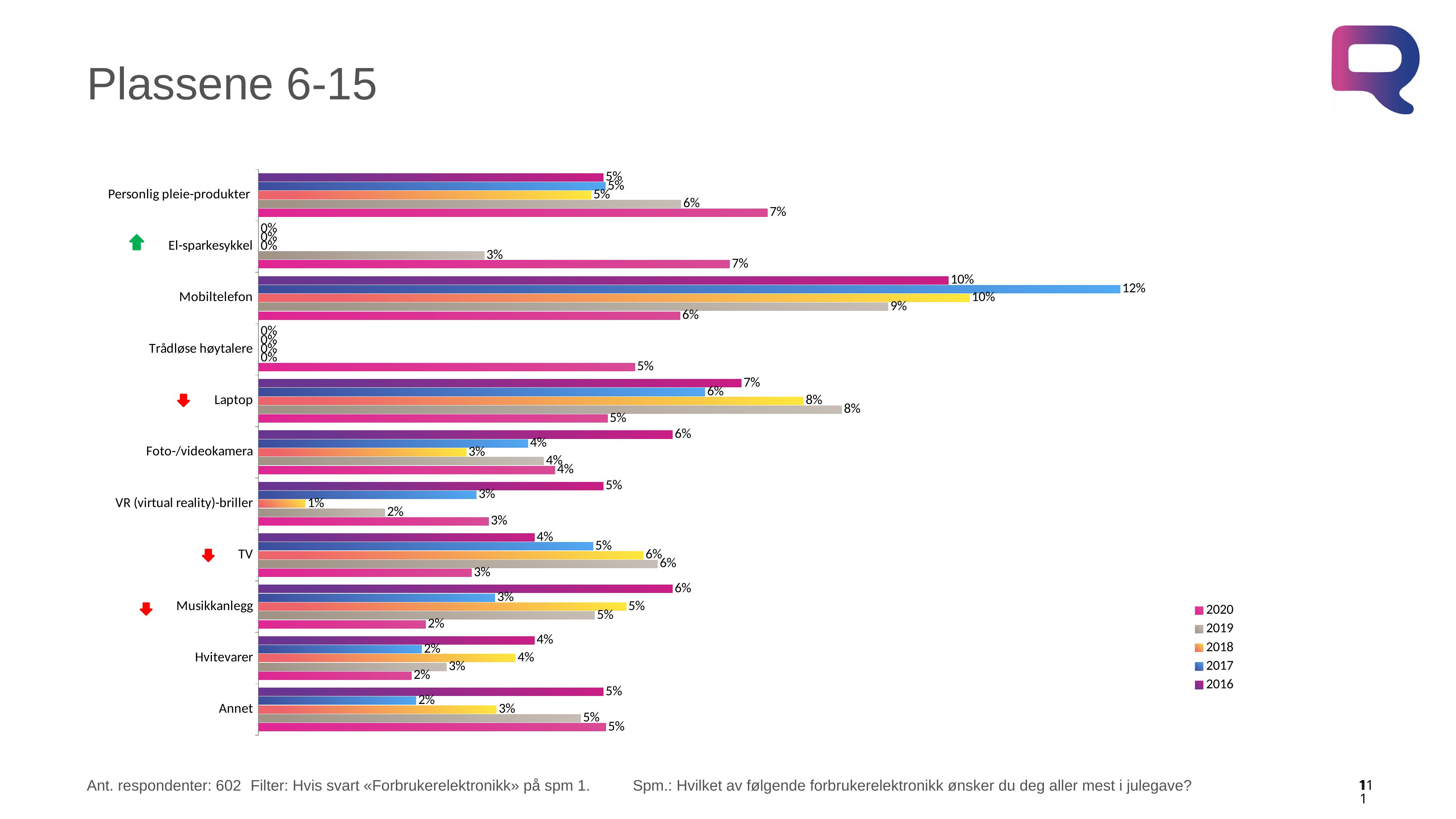
Which is larger for Laptop: the 2019 value or the 2020 value? 2019 How many series does the legend list? 5 Which category has the highest value for the 2020 series? Personlig pleie-produkter and El-sparkesykkel (7%) What is the value for Mobiltelefon in 2017? 12% Does the value for Mobiltelefon rise or fall from 2017 through 2020? Fall What is the difference between the 2017 and 2020 values for Mobiltelefon? 6% What is the value for VR (virtual reality)-briller in 2018? 1% Which years are listed in the legend? 2020, 2019, 2018, 2017, 2016 What is the value for El-sparkesykkel in 2020? 7% What kind of chart is shown on the slide? Bar chart Which category has the highest value for the 2017 series? Mobiltelefon How many categories are shown on the chart? 11